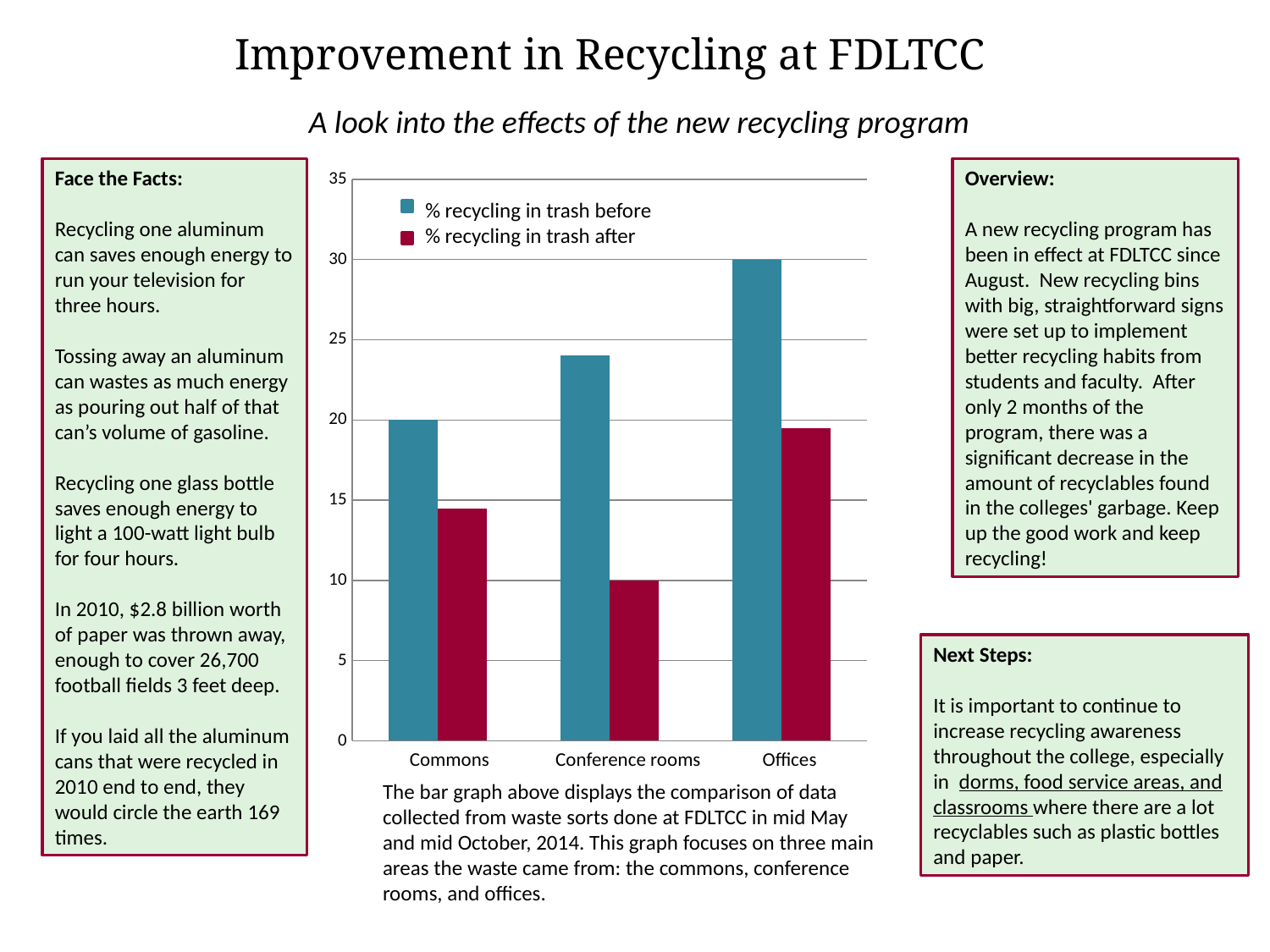
What is the value of '% recycling in trash before' for Offices? 30 What is the value of '% recycling in trash before' for Commons? 20 How many categories are shown on the x axis of the chart? 3 Is the value of '% recycling in trash before' for Conference rooms greater or less than 20? greater What is the value of '% recycling in trash after' for Conference rooms? 10 What kind of chart is shown on the slide? bar chart How many series does the chart legend list? 2 What is the difference between '% recycling in trash before' for Offices and for Commons? 10 Which category has the highest value for '% recycling in trash before'? Offices For Offices, which is larger: '% recycling in trash before' or '% recycling in trash after'? % recycling in trash before Which category has the lowest value for '% recycling in trash after'? Conference rooms